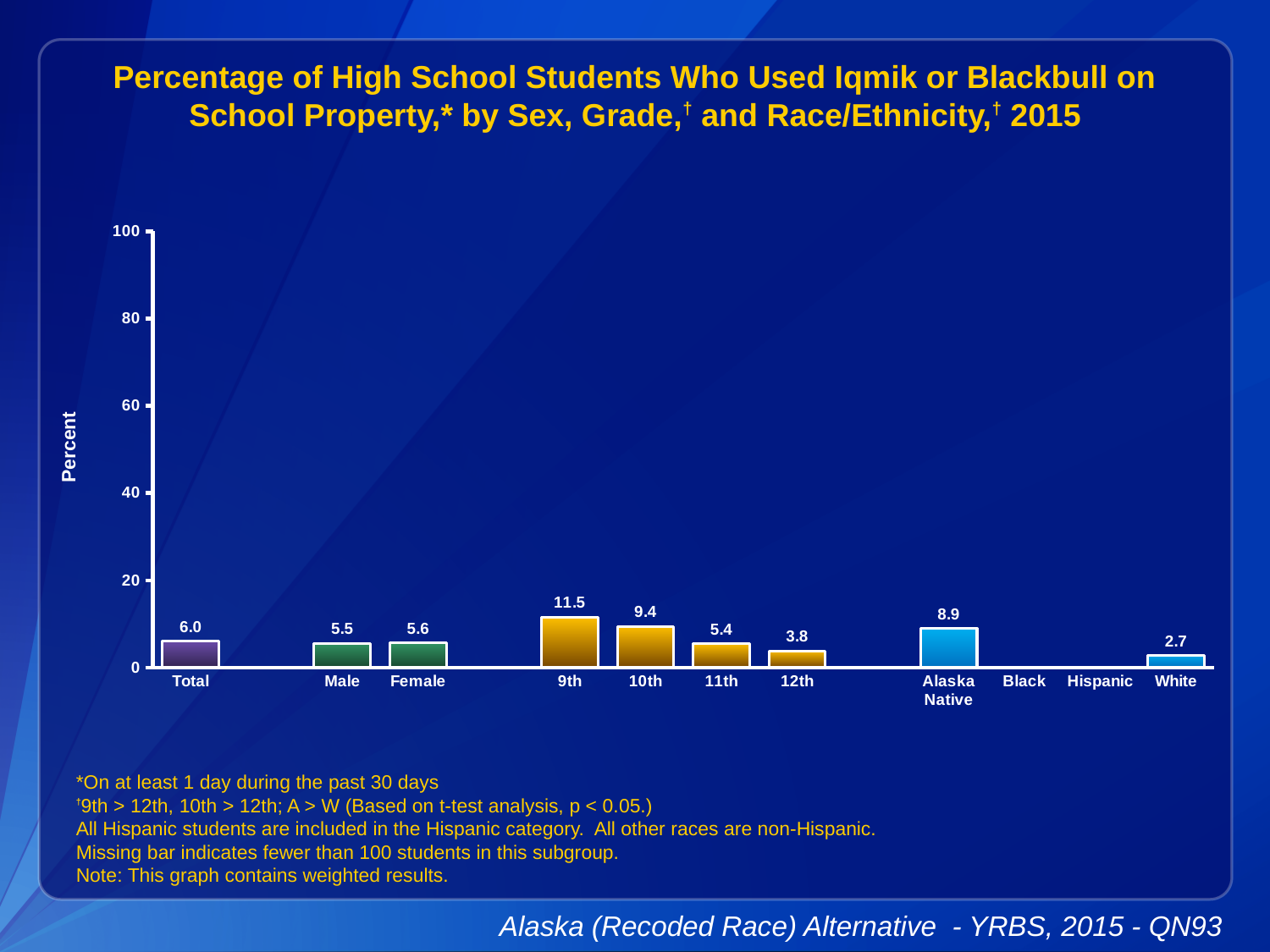
What is the value for Total? 6.0 What is the difference between the values for 9th and 12th grade? 7.7 Is the value for 9th grade greater or less than 20? less What kind of chart is this? bar chart Which category has the highest value? 9th What is the value for Alaska Native students? 8.9 Among the grade categories, which has the lowest value? 12th What is the value for White students? 2.7 What is the value for 9th grade students? 11.5 Which is larger, the value for 10th grade or the value for Alaska Native students? 10th Do the values fall or rise from 9th grade to 12th grade? fall How many categories have a bar plotted? 9